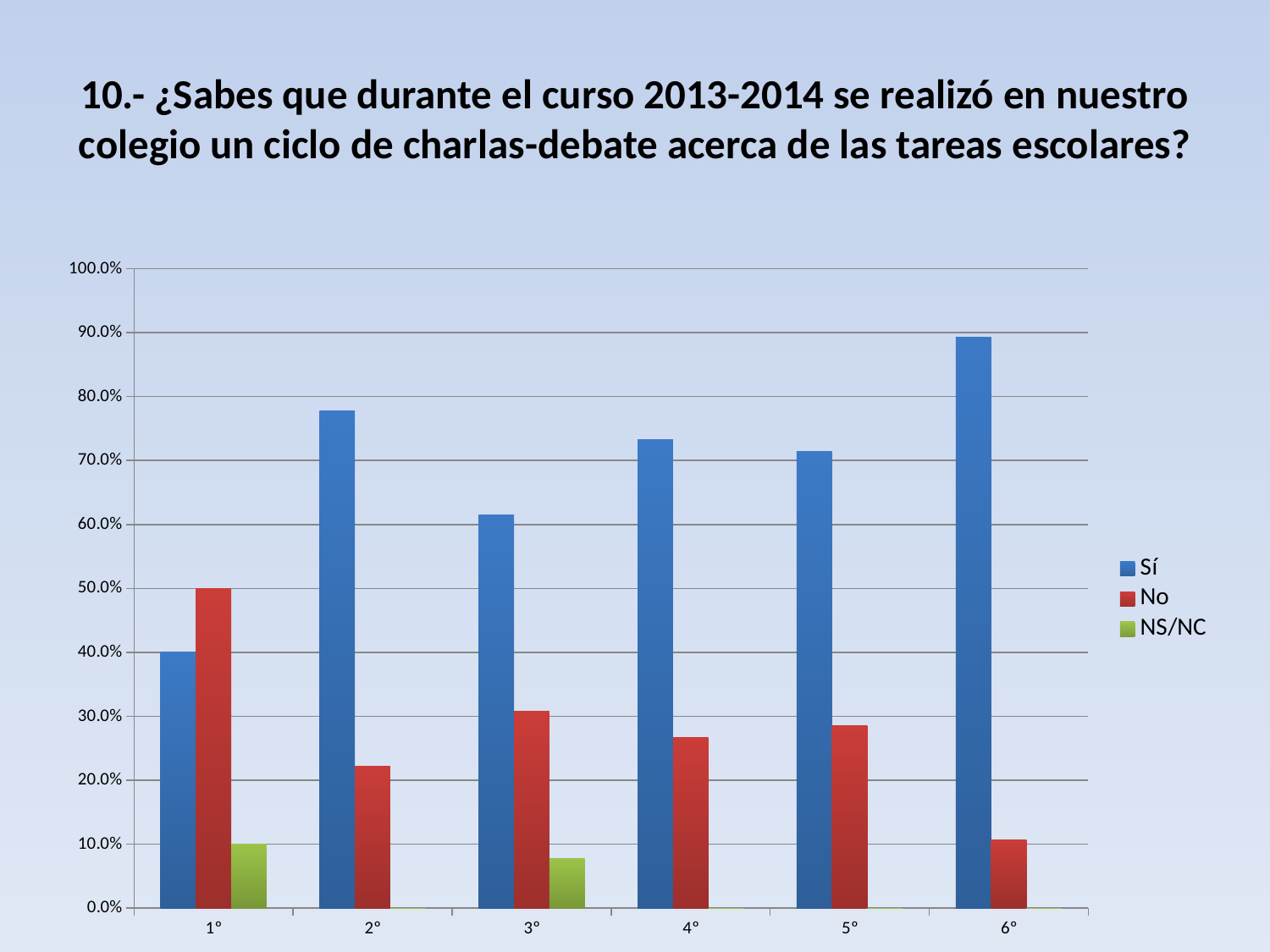
Is the Sí value for 4° greater or less than 70.0%? greater Is the Sí value for 6° greater or less than 80.0%? greater How many categories are shown on the x axis? 6 Which category has the highest value for Sí? 6° Which legend entry is shown in green? NS/NC How many series does the legend list? 3 Which category has the lowest value for Sí? 1° Which is larger, the Sí value for 2° or the Sí value for 3°? 2° Which category has the lowest value for No? 6° What kind of chart is shown on the slide? bar chart Is the No value for 2° greater or less than 30.0%? less Which category has the highest value for No? 1°